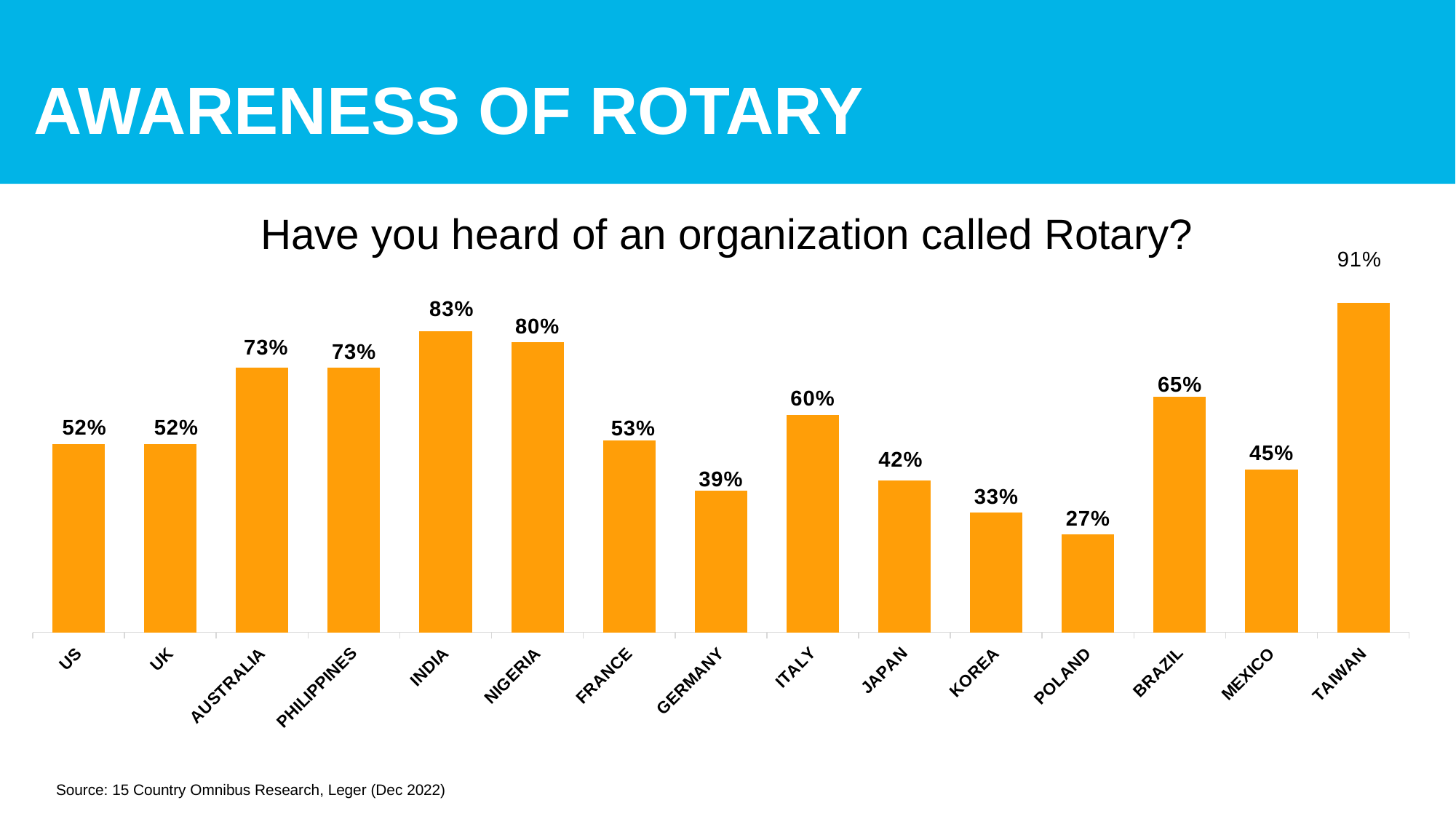
What is the difference between the values for Nigeria and Germany? 41% What type of chart is shown on the slide? Bar chart How many countries are shown on the chart? 15 Which country has the lowest awareness of Rotary? Poland What colour are the bars in the chart? Orange What is the title of the chart? Have you heard of an organization called Rotary? Which country has the highest awareness of Rotary? Taiwan Which has a higher value, Italy or Japan? Italy What is the difference between the values for Taiwan and the US? 39% What is the value shown for Brazil? 65% What is the value shown for Poland? 27% What percentage of respondents in India have heard of Rotary? 83%